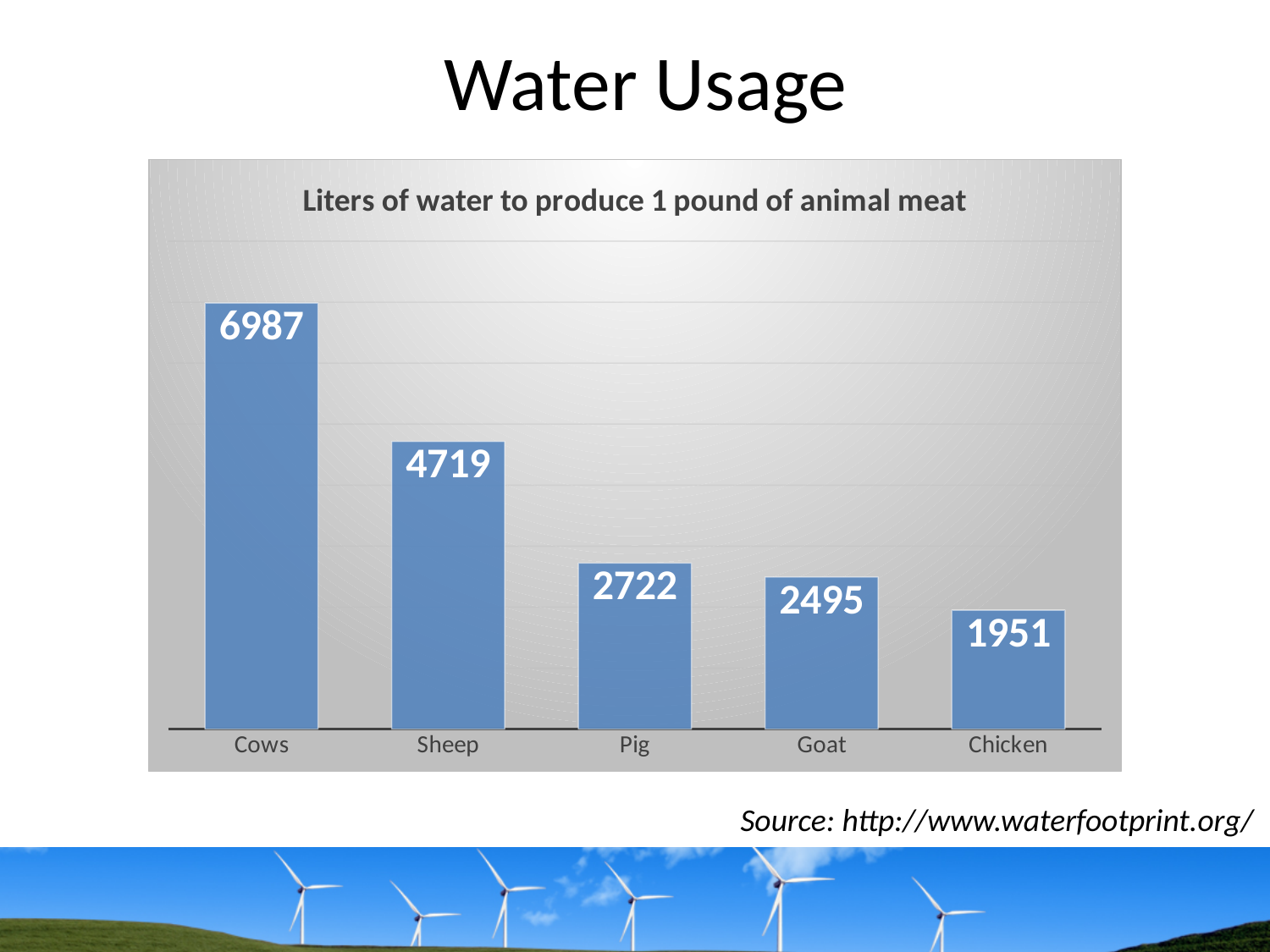
What is the difference between the values for Pig and Goat? 227 Which animal requires the most liters of water to produce 1 pound of meat? Cows What type of chart is shown on the slide? Bar chart What is the value shown for Chicken? 1951 What is the value shown for Sheep? 4719 What is the title of the chart? Liters of water to produce 1 pound of animal meat Do the values rise or fall moving from Cows to Chicken along the x axis? Fall Which animal requires the fewest liters of water to produce 1 pound of meat? Chicken How many animal categories are shown in the chart? 5 How many liters of water are needed to produce 1 pound of cow meat? 6987 Which has a higher value, Pig or Goat? Pig What is the difference between the values for Cows and Sheep? 2268